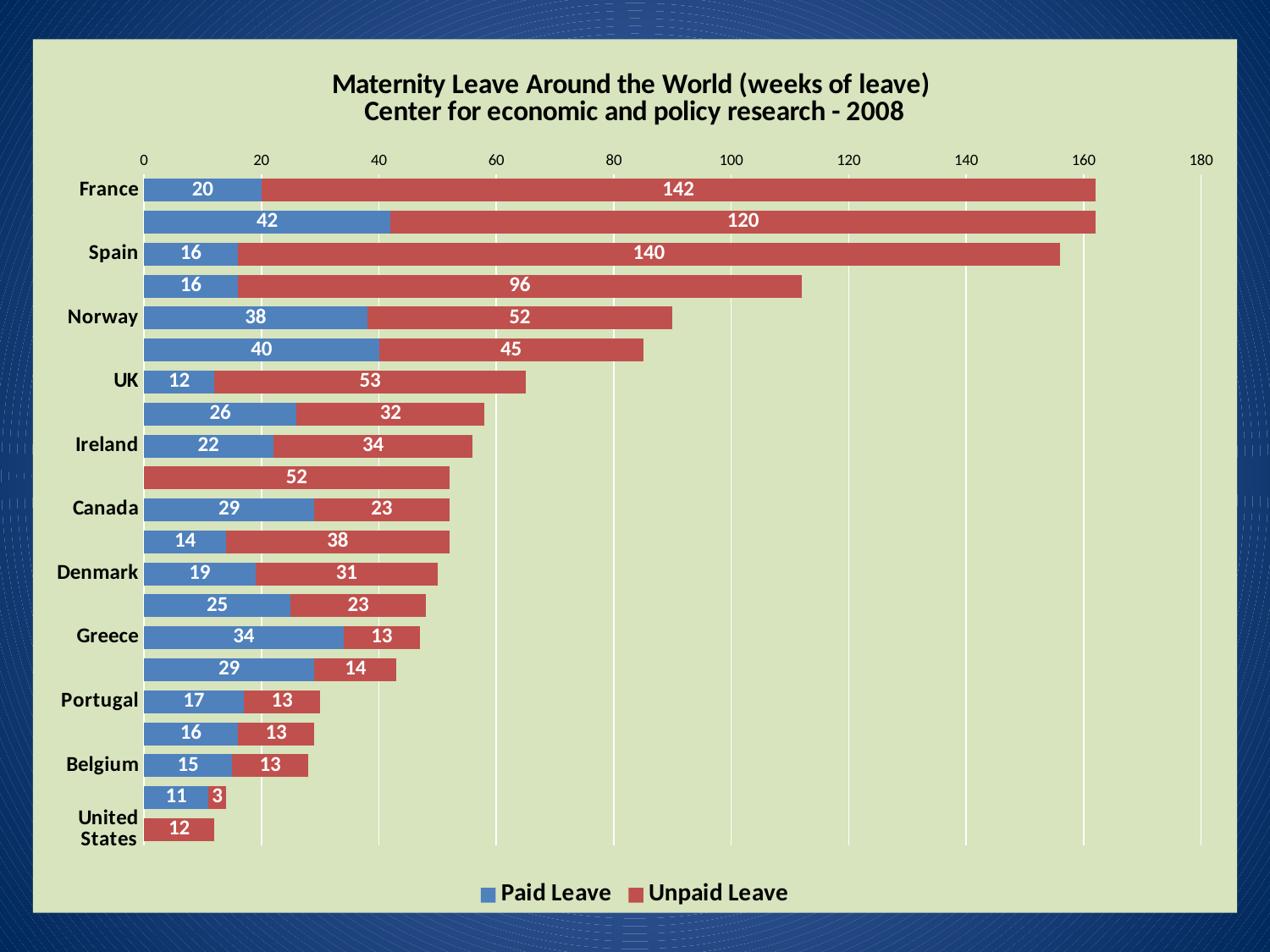
Is the total length of the Norway bar greater or less than 80? greater What is the difference between the Unpaid Leave values for France and Spain? 2 How many series does the legend list? 2 What is the Paid Leave value for France? 20 What is the total weeks of leave (paid plus unpaid) for the UK bar? 65 Among the labelled countries, which has the highest Unpaid Leave value? France What is the Unpaid Leave value for Spain? 140 What is the Unpaid Leave value for the United States? 12 What is the Paid Leave value for Norway? 38 What is the total weeks of leave (paid plus unpaid) for the Canada bar? 52 What kind of chart is shown on the slide? Stacked bar chart Which has the larger Paid Leave value, Greece or Portugal? Greece